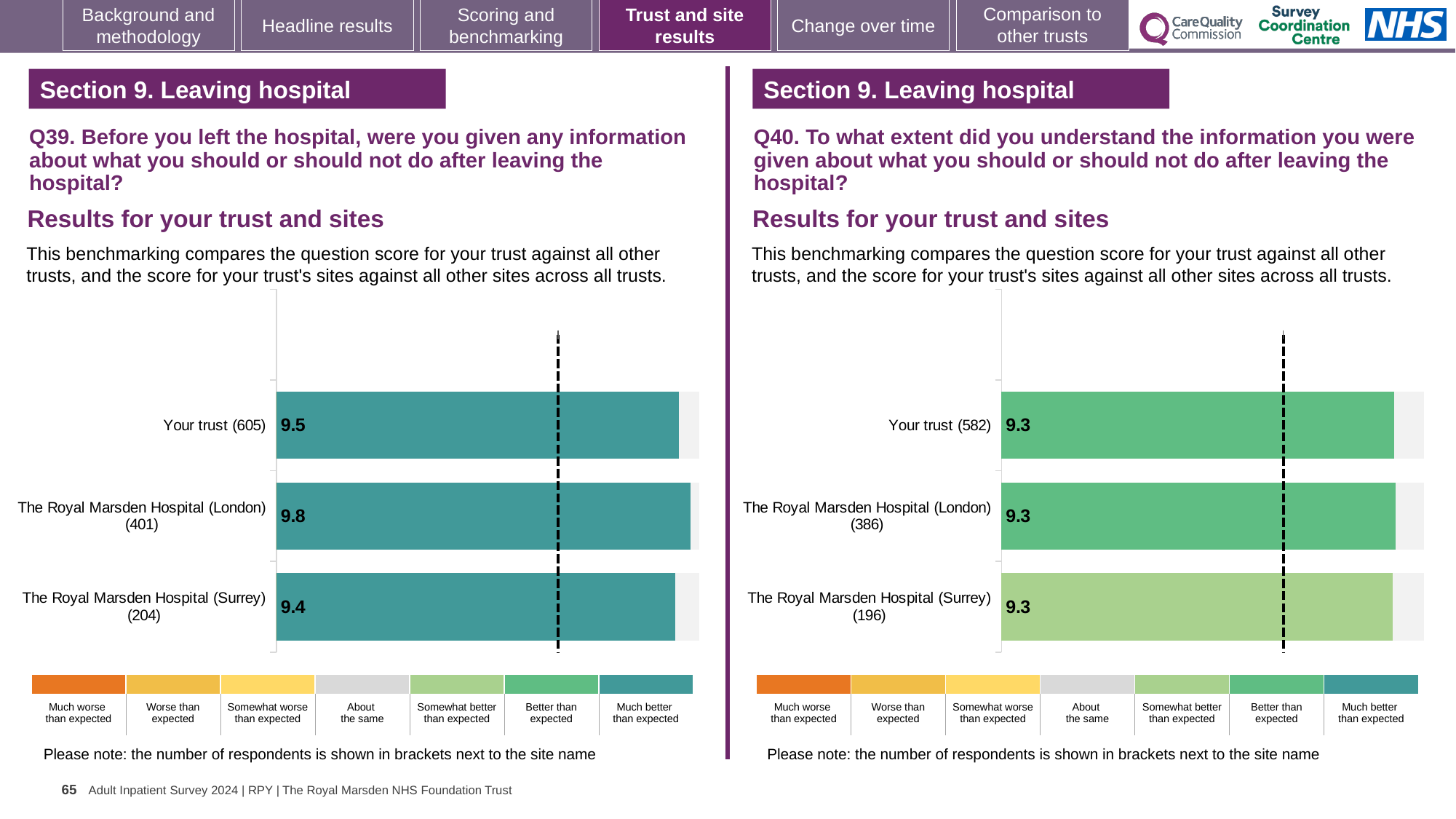
On the Q39 chart (left), what is the difference between the scores for The Royal Marsden Hospital (London) and The Royal Marsden Hospital (Surrey)? 0.4 What kind of chart is shown on the Q39 chart (left)? Bar chart On the Q40 chart (right), what is the score for The Royal Marsden Hospital (Surrey) (196)? 9.3 On the Q39 chart (left), what is the score for Your trust (605)? 9.5 On the Q40 chart (right), which benchmark category does the colour of the bar for The Royal Marsden Hospital (Surrey) correspond to in the legend? Somewhat better than expected On the Q39 chart (left), which has the larger score: Your trust or The Royal Marsden Hospital (London)? The Royal Marsden Hospital (London) On the Q39 chart (left), which site or trust has the highest score? The Royal Marsden Hospital (London) On the Q40 chart (right), what is the score for Your trust (582)? 9.3 On the Q39 chart (left), which site or trust has the lowest score? The Royal Marsden Hospital (Surrey) On the Q39 chart (left), what is the score for The Royal Marsden Hospital (London) (401)? 9.8 On the Q40 chart (right), how many bars are plotted? 3 On the Q39 chart (left), what is the score for The Royal Marsden Hospital (Surrey) (204)? 9.4